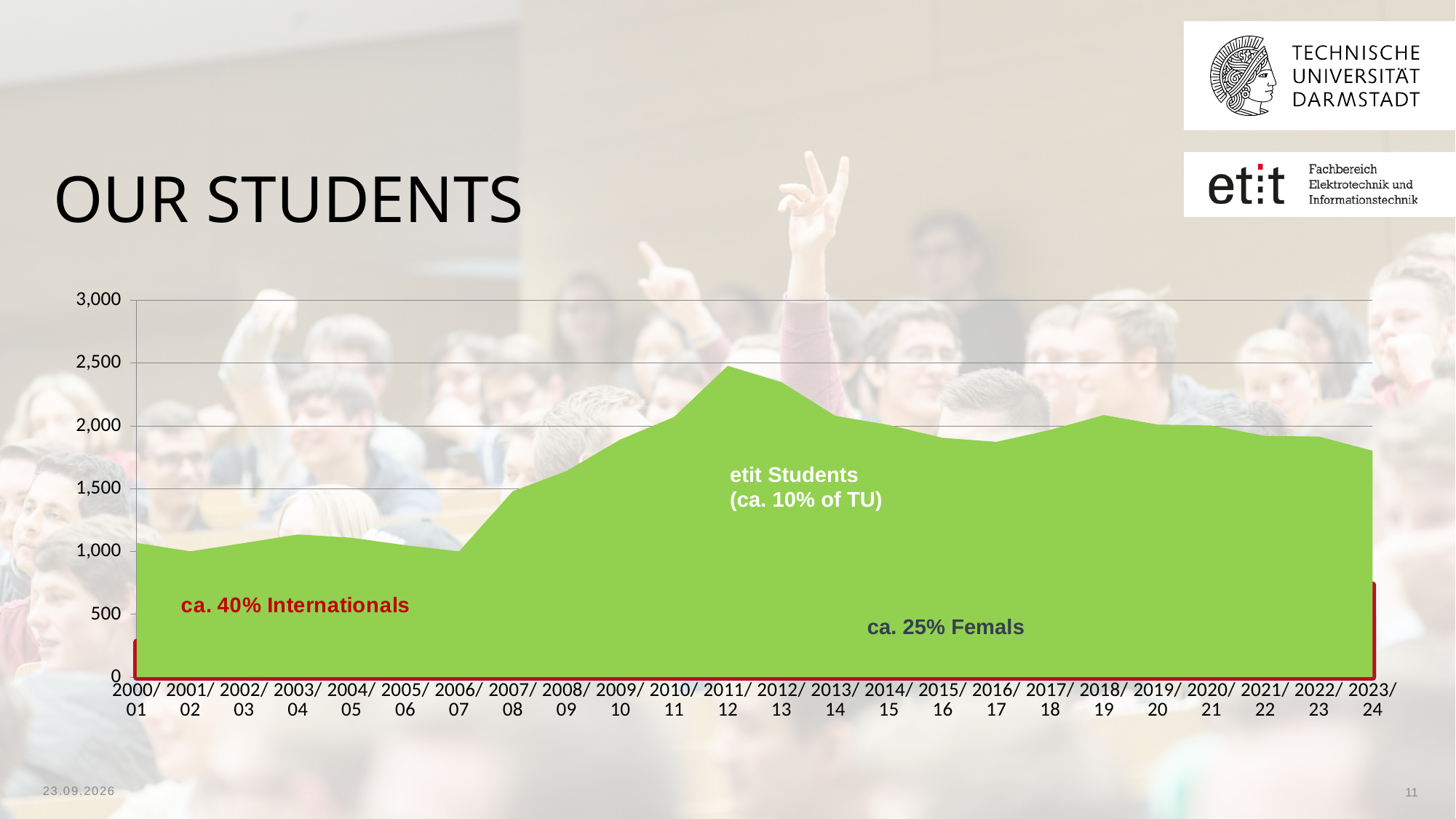
How many academic years are plotted along the x axis? 24 Do the values rise or fall from 2011/12 to 2016/17? fall Is the value for 2023/24 greater or less than 2,000? less Is the value for 2006/07 greater or less than 1,500? less In which academic year is the number of etit students highest? 2011/12 What kind of chart is shown on the slide? area chart Is the value for 2011/12 greater or less than 2,000? greater Which is larger, the value for 2011/12 or the value for 2000/01? 2011/12 Do the values rise or fall from 2006/07 to 2011/12? rise According to the annotation on the chart, what share of etit students are internationals? ca. 40% According to the annotation on the chart, etit students make up roughly what share of TU? ca. 10%